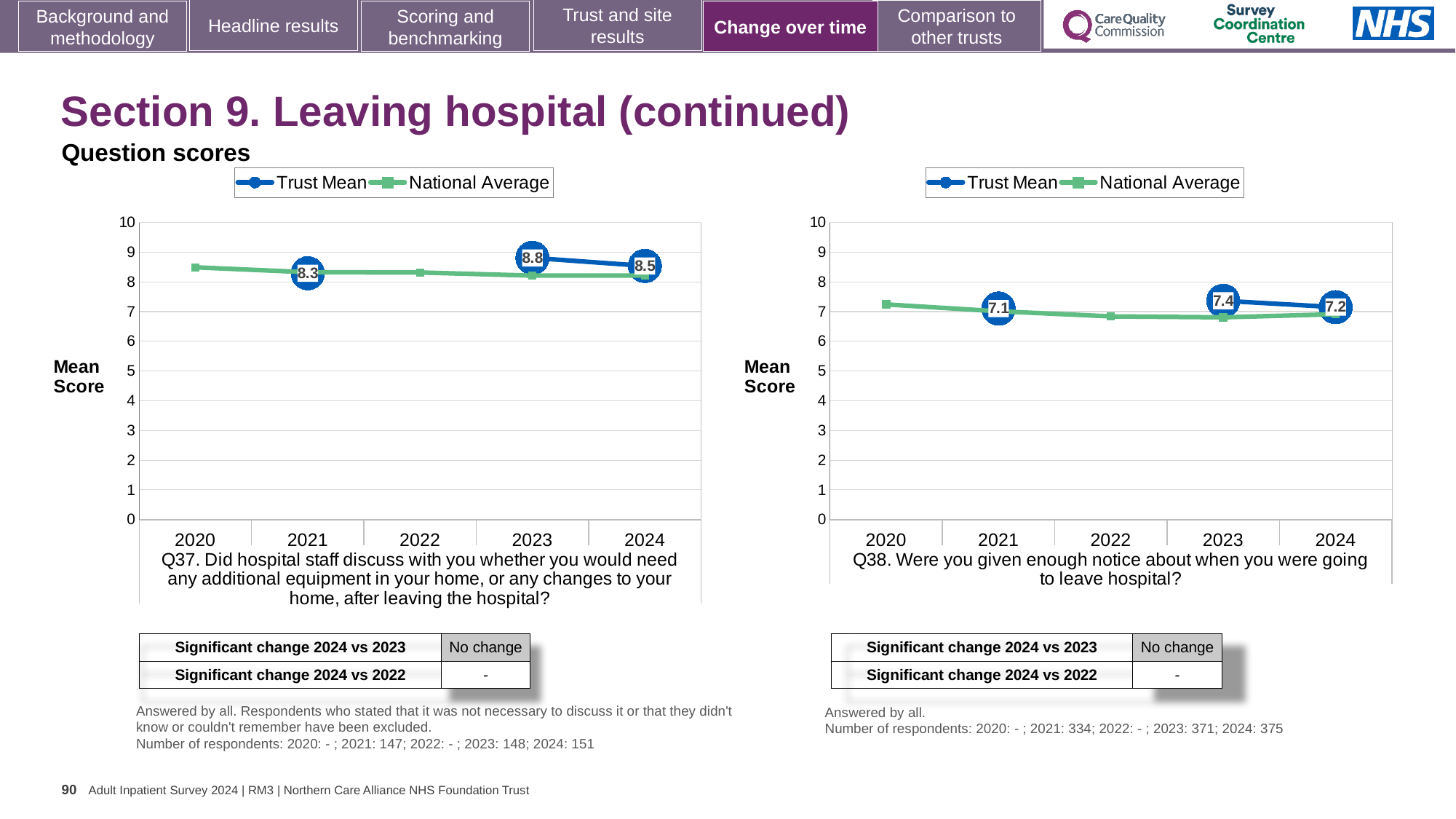
In the Q37 chart (left), is the Trust Mean score for 2021 greater or less than the Trust Mean score for 2024? less In the Q37 chart (left), what is the Trust Mean score for 2023? 8.8 In the Q37 chart (left), what is the difference between the Trust Mean scores for 2023 and 2021? 0.5 What kind of chart is the Q38 chart (right)? Line chart In the Q38 chart (right), is the National Average value for 2020 greater or less than 8? less In the Q38 chart (right), what is the Trust Mean score for 2024? 7.2 In the Q38 chart (right), what is the Trust Mean score for 2021? 7.1 In the Q38 chart (right), what is the difference between the Trust Mean scores for 2023 and 2024? 0.2 In the Q37 chart (left), which year has the highest labelled Trust Mean score? 2023 How many series does the legend of the Q37 chart (left) list? 2 In the Q38 chart (right), which year has the lowest labelled Trust Mean score? 2021 In the Q37 chart (left), what is the Trust Mean score for 2024? 8.5